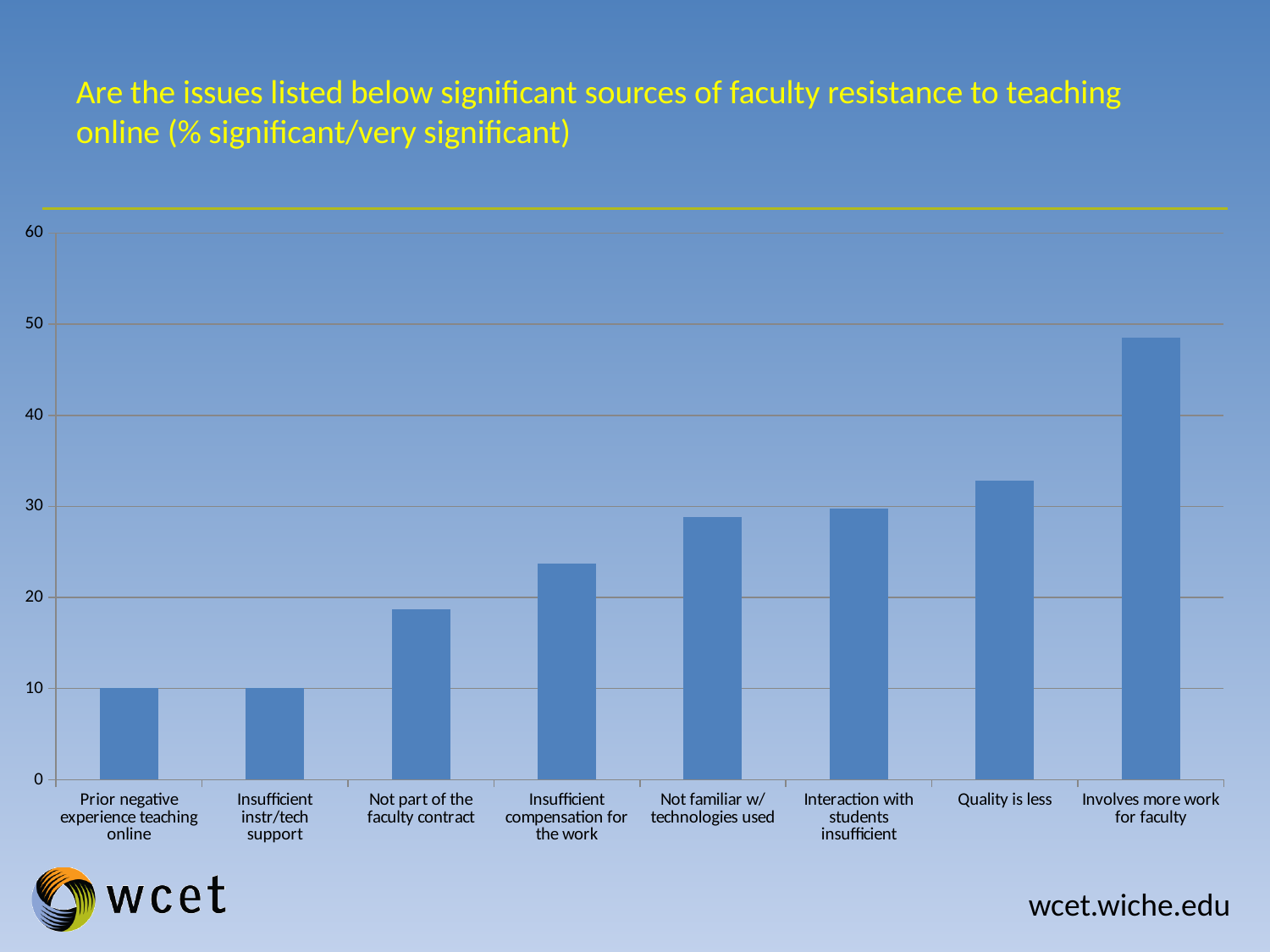
Is the value for "Insufficient compensation for the work" greater or less than 20? greater Is the value for "Quality is less" greater or less than 30? greater What kind of chart is shown on the slide? bar chart Which has a larger value: "Quality is less" or "Not familiar w/ technologies used"? Quality is less Is the value for "Involves more work for faculty" greater or less than 40? greater Do the bar values generally rise or fall from left to right along the x axis? rise How many categories (issues) are shown on the x axis of the chart? 8 Which has a larger value: "Insufficient compensation for the work" or "Not part of the faculty contract"? Insufficient compensation for the work Which issue has the highest value in the chart? Involves more work for faculty What is the highest value shown on the chart's vertical axis? 60